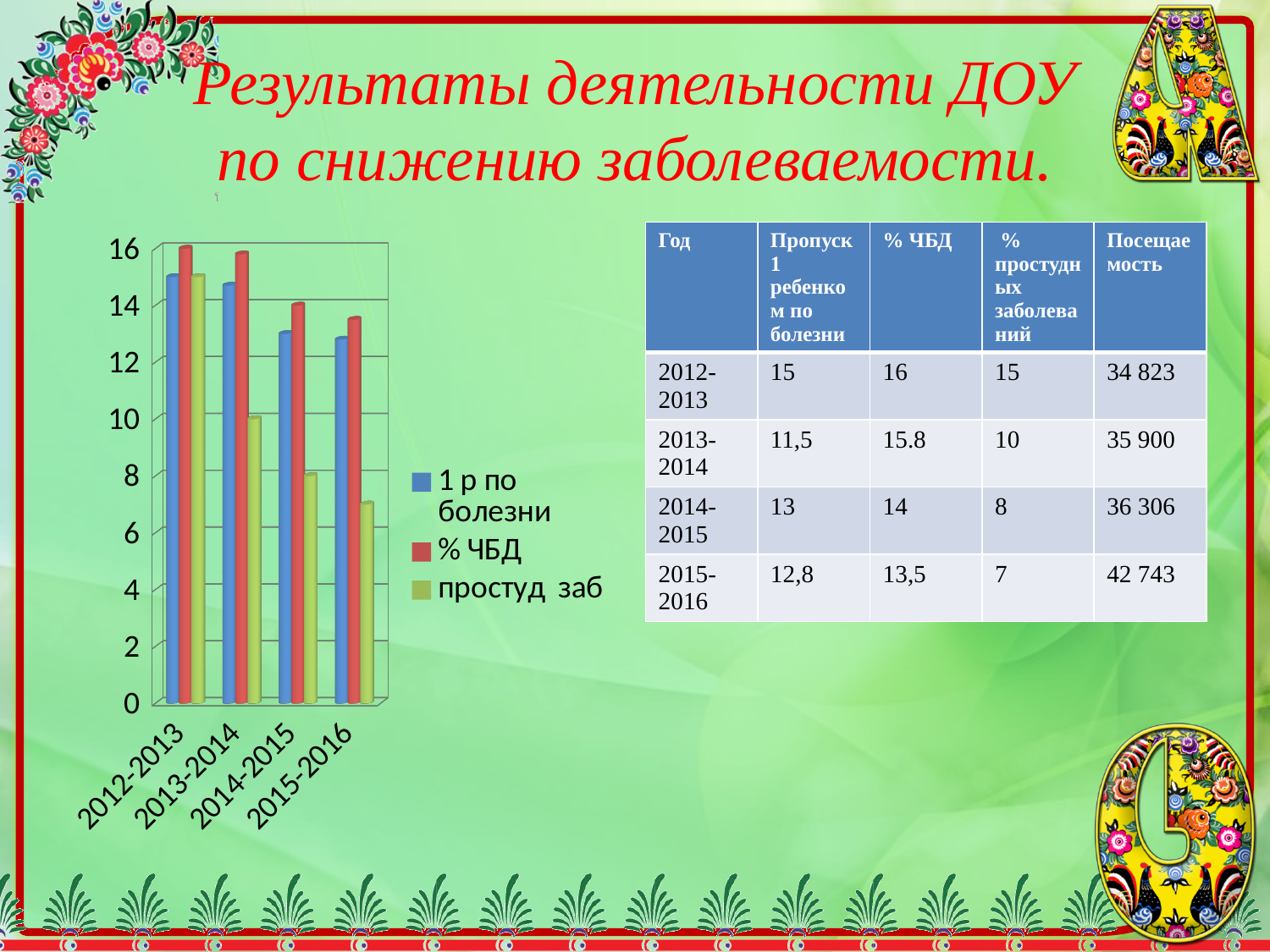
In 2013-2014, which is larger: '% ЧБД' or 'простуд заб'? % ЧБД Is the value for '% ЧБД' in 2012-2013 greater or less than 14? greater How many series does the chart legend list? 3 Does the value for '% ЧБД' rise or fall across the years on the x axis? fall In which year is the 'простуд заб' bar lowest? 2015-2016 Is the value for '1 р по болезни' in 2015-2016 greater or less than 14? less What kind of chart is shown on the left of the slide? bar chart Which series is shown in red in the chart legend? % ЧБД Is the value for 'простуд заб' in 2015-2016 greater or less than 10? less In which year is the 'простуд заб' bar highest? 2012-2013 How many year categories are shown on the x axis of the chart? 4 Does the value for 'простуд заб' rise or fall from 2012-2013 to 2015-2016? fall